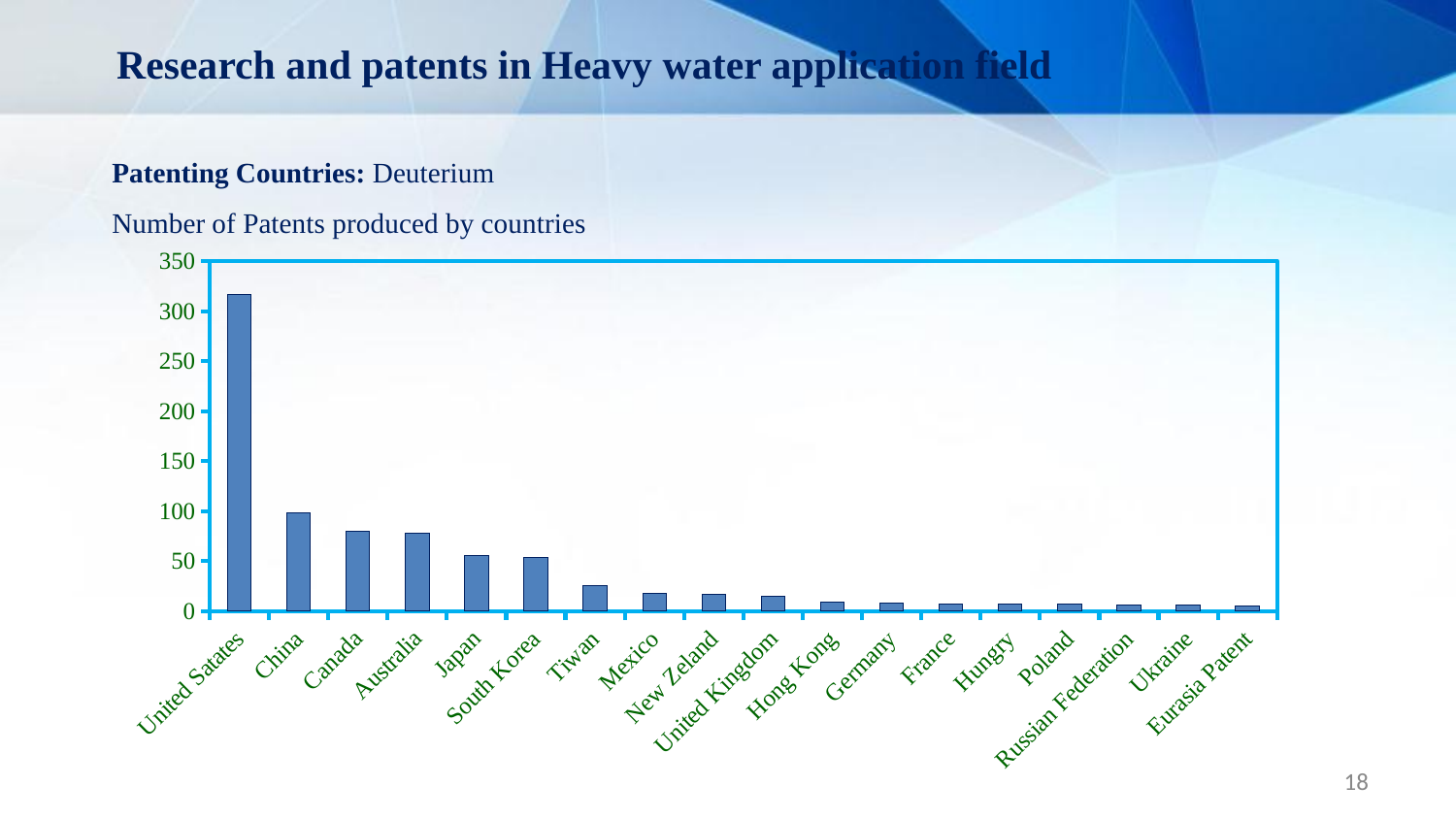
Which has more patents, United Satates or China? United Satates Is the value for United Satates greater or less than 300? greater Is the value for China greater or less than 50? greater What kind of chart is shown on the slide? bar chart Is the value for Tiwan greater or less than 50? less Which country has the highest number of patents in the chart? United Satates Do the bar values rise or fall moving from left to right along the x axis? fall How many countries (categories) are shown on the x axis of the chart? 18 What is the title text shown directly above the chart? Number of Patents produced by countries Which has more patents, Canada or Japan? Canada